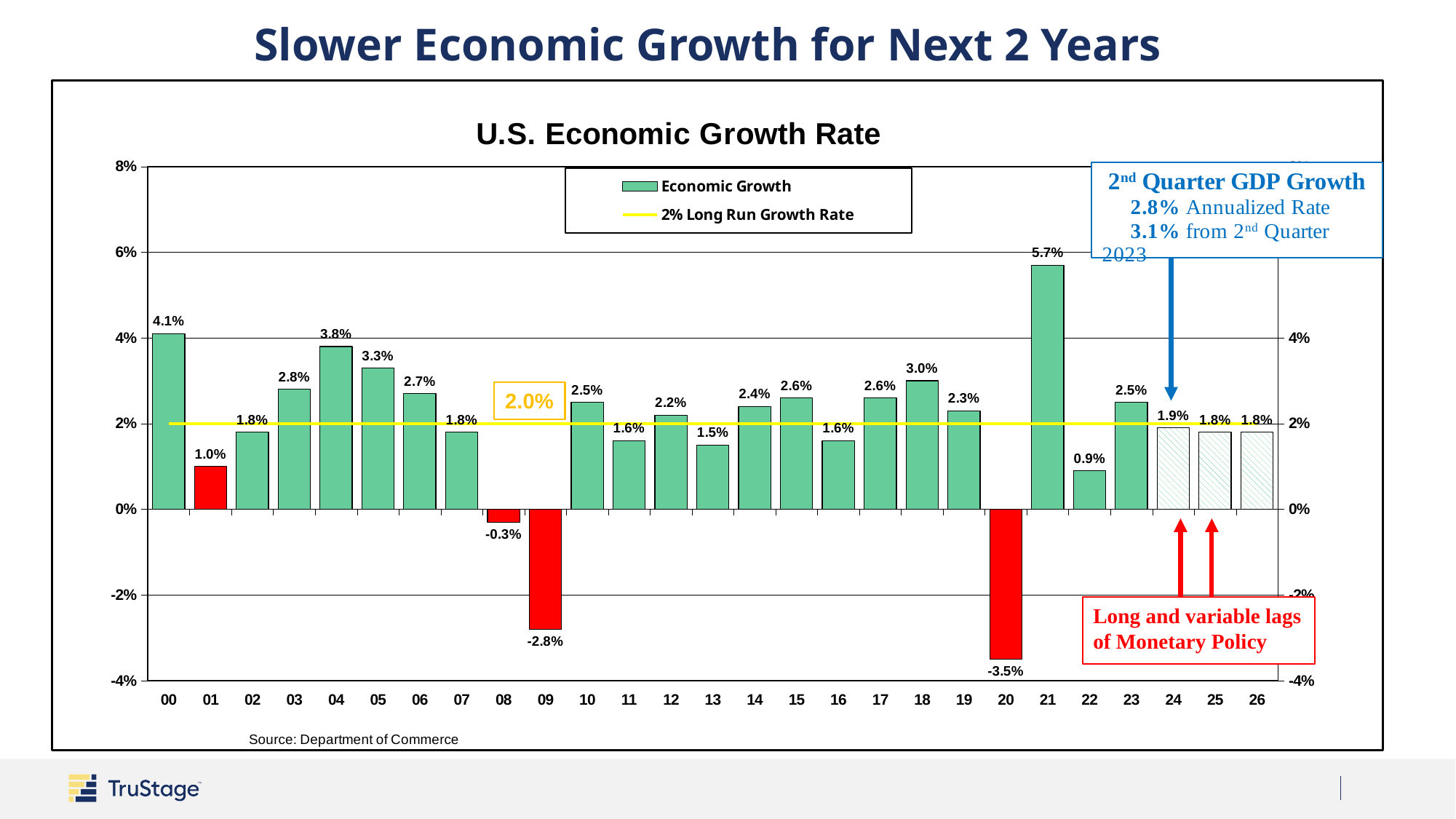
How many entries does the chart legend list? 2 Which year had the higher growth rate, 2004 (04) or 2018 (18)? 04 Is the growth rate for 2022 (22) greater or less than 2%? less What is the forecast economic growth rate for 2024 (24)? 1.9% Which year has the highest economic growth rate on the chart? 21 What type of chart is used to show the U.S. Economic Growth Rate? Bar chart Which year has the lowest economic growth rate on the chart? 20 What is the economic growth rate shown for 2009 (09)? -2.8% What is the economic growth rate shown for 2021 (21)? 5.7% What is the difference between the growth rate in 2000 (00) and in 2001 (01)? 3.1% What value does the yellow horizontal line on the chart represent? 2% Long Run Growth Rate How many years are shown on the x axis of the chart? 27